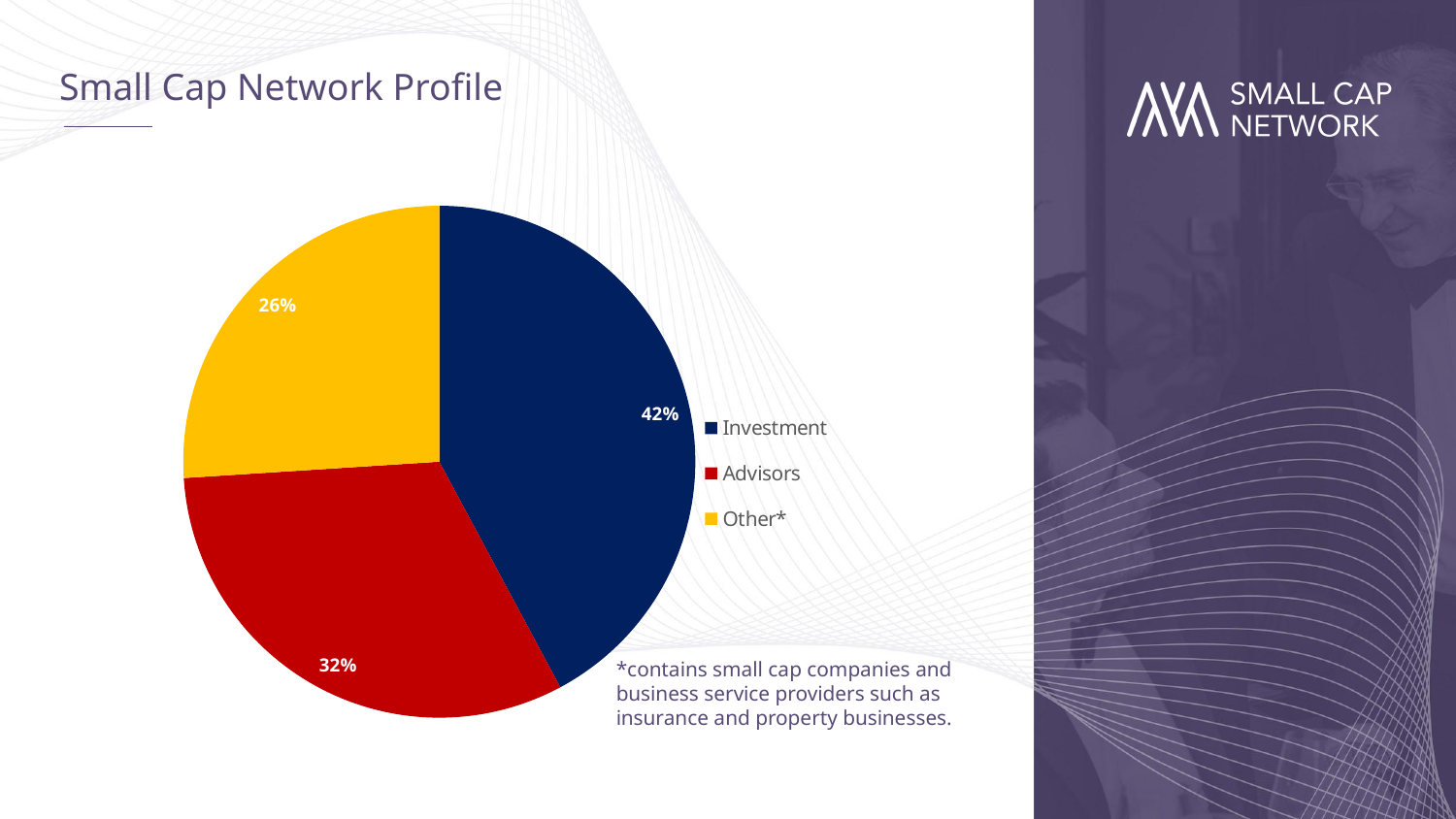
What colour is the Advisors slice? Red What kind of chart is shown on the slide? Pie chart What is the difference in percentage points between Investment and Advisors? 10 Which is larger, the Advisors slice or the Other* slice? Advisors What share of the pie does Advisors represent? 32% What is the difference in percentage points between Advisors and Other*? 6 What share of the pie does Other* represent? 26% How many slices does the pie chart have? 3 Which category has the smallest slice of the pie? Other* Which category has the largest slice of the pie? Investment What share of the pie does Investment represent? 42% What is the title of the slide containing the chart? Small Cap Network Profile